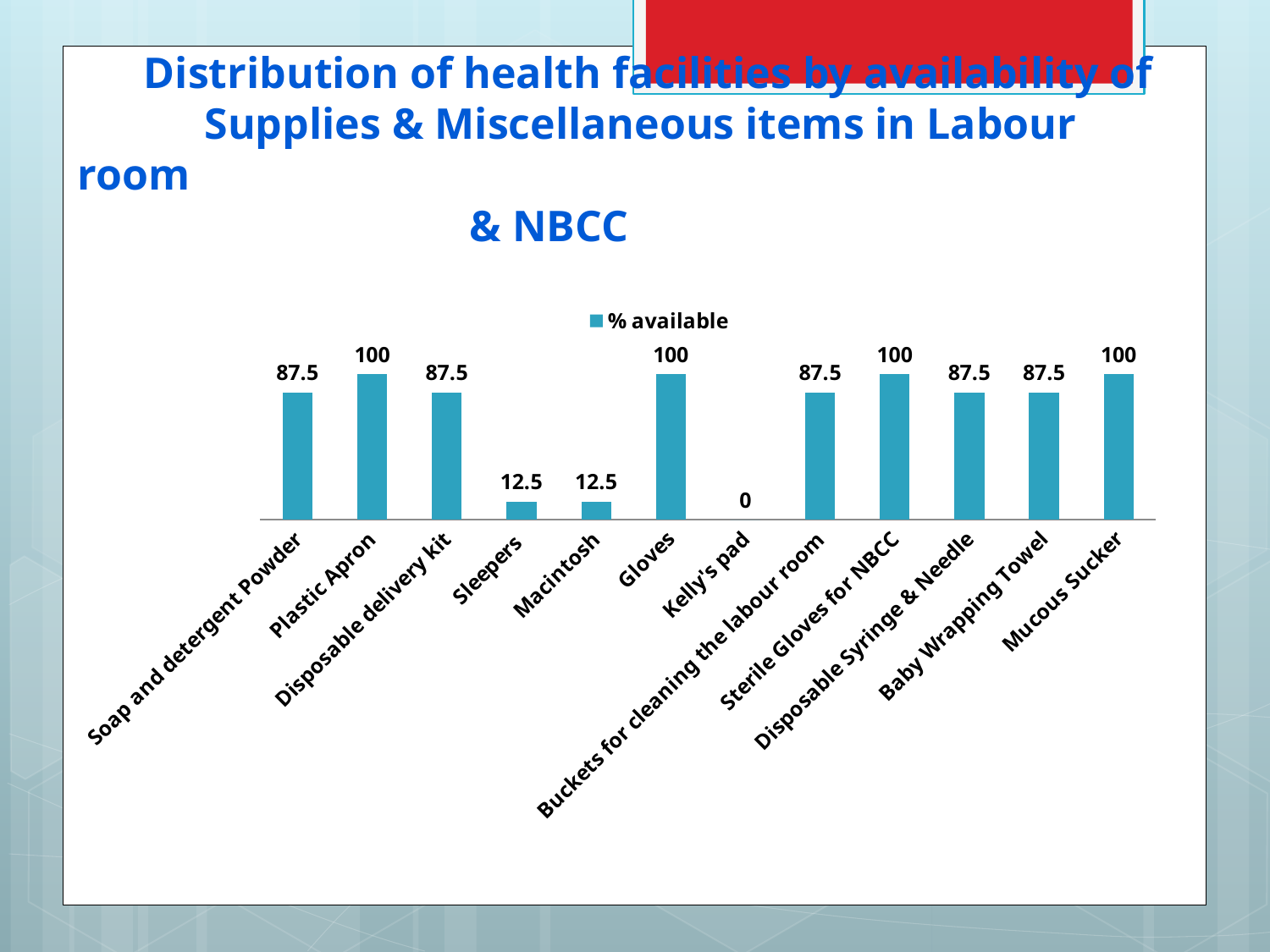
What is the % available value for Kelly's pad? 0 What is the % available value for Sleepers? 12.5 How many series does the legend list? 1 Which item has the lowest % available value? Kelly's pad What is the % available value for Plastic Apron? 100 Which has a higher % available value, Disposable delivery kit or Sleepers? Disposable delivery kit What is the difference between the % available values for Sterile Gloves for NBCC and Baby Wrapping Towel? 12.5 What is the difference between the % available values for Gloves and Macintosh? 87.5 How many items are shown on the x axis of the chart? 12 What kind of chart is shown on the slide? Bar chart What is the % available value for Mucous Sucker? 100 What is the % available value for Buckets for cleaning the labour room? 87.5